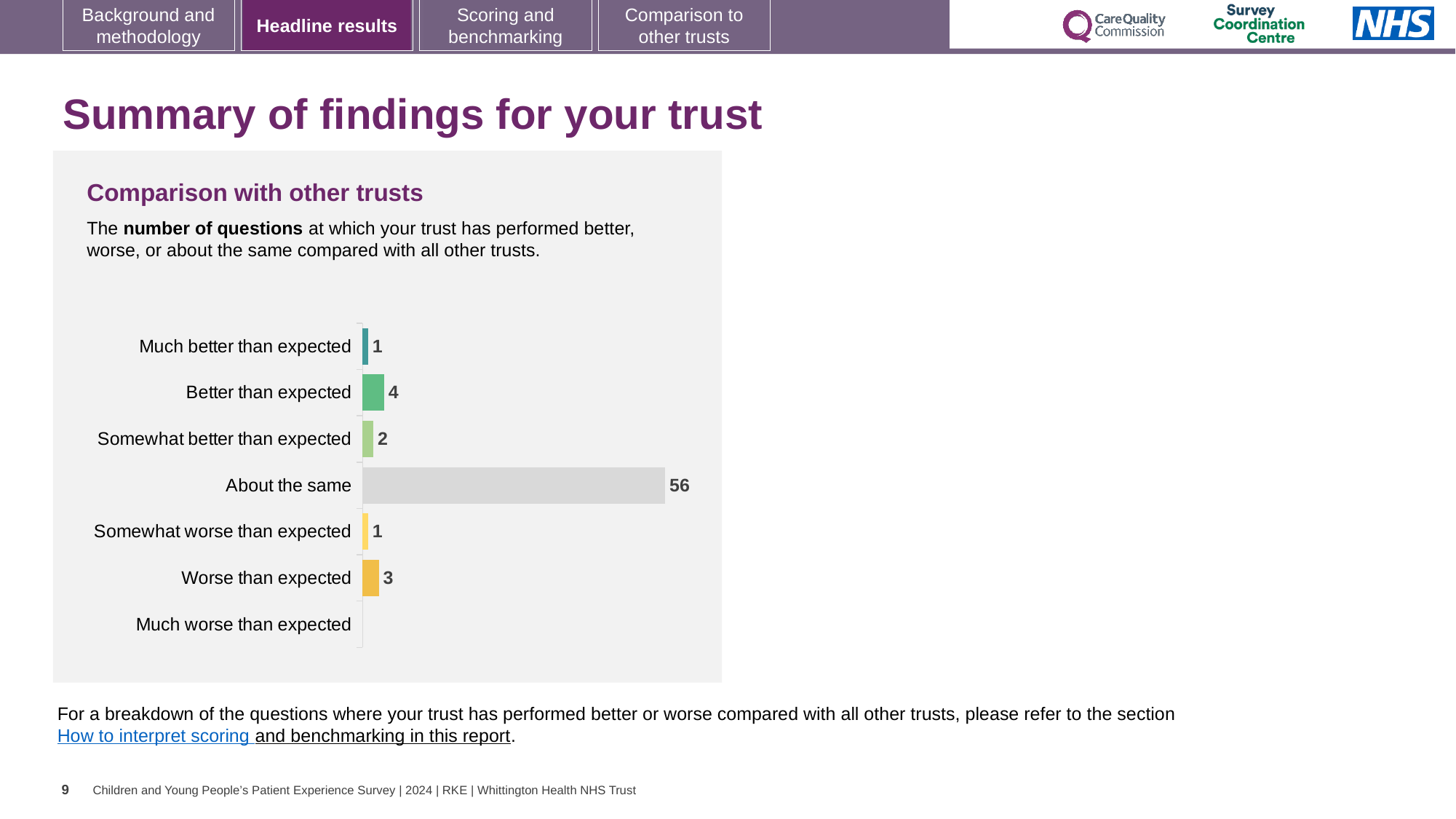
How many questions were rated 'Worse than expected'? 3 Which category has the highest number of questions? About the same How many questions were rated 'Better than expected'? 4 How many questions were rated 'Much better than expected'? 1 How many questions were rated 'Somewhat better than expected'? 2 What is the difference between the number of questions rated 'About the same' and 'Better than expected'? 52 Which has more questions: 'Better than expected' or 'Worse than expected'? Better than expected What is the title of the chart? Comparison with other trusts What is the total number of questions rated 'Somewhat worse than expected' and 'Worse than expected' combined? 4 What kind of chart is shown on the slide? Bar chart How many questions were rated 'About the same'? 56 How many categories are shown on the chart? 7